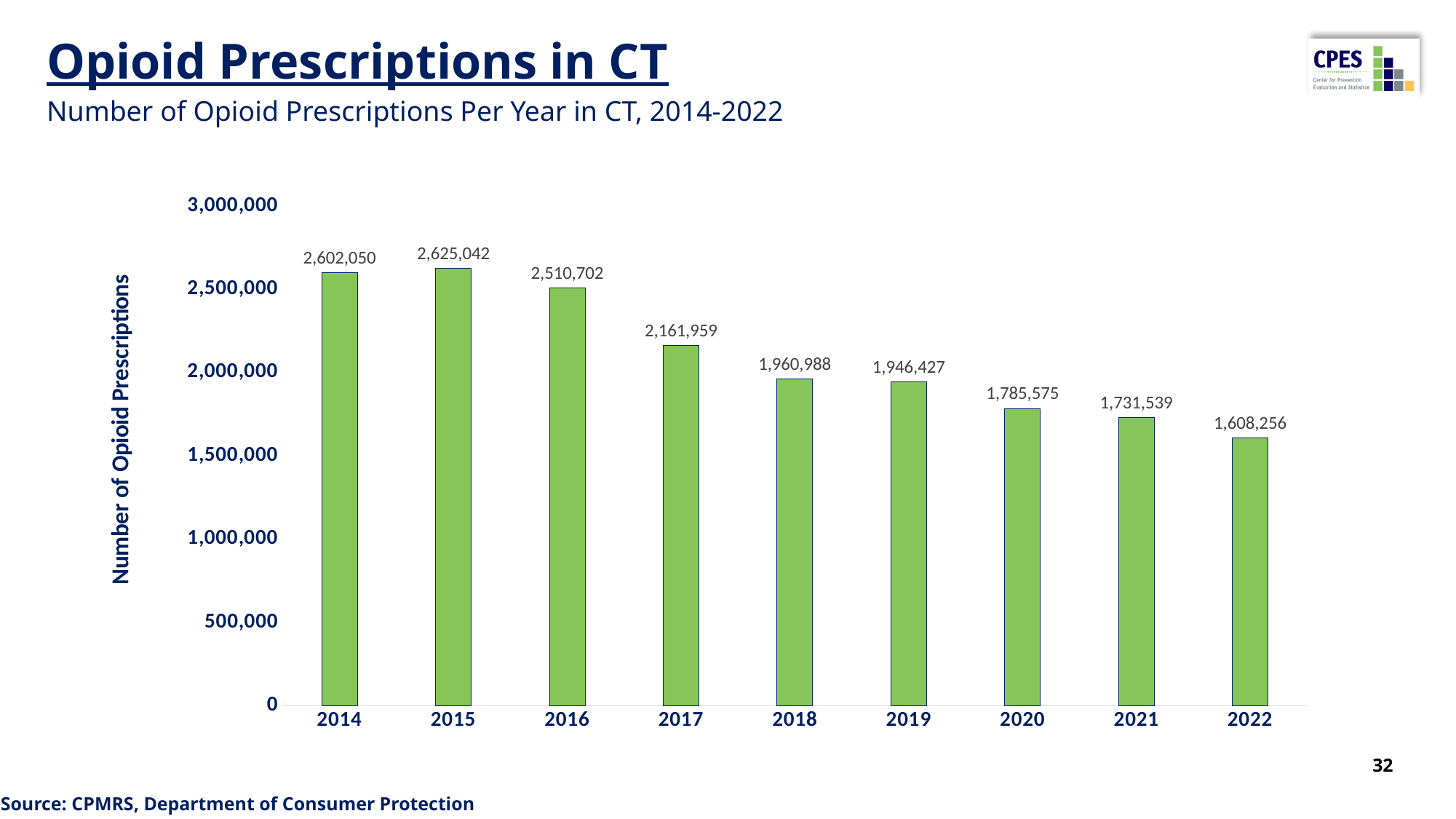
How many years are shown on the x axis? 9 Which year had the lowest number of opioid prescriptions? 2022 How many opioid prescriptions were there in CT in 2014? 2,602,050 By how much did the number of opioid prescriptions fall from 2014 to 2022? 993,794 What is the value for 2022? 1,608,256 What type of chart is shown on the slide? bar chart What is the overall trend in opioid prescriptions from 2015 to 2022? falling Which year had the highest number of opioid prescriptions? 2015 What is the number of opioid prescriptions shown for 2019? 1,946,427 Which year had more opioid prescriptions, 2018 or 2019? 2018 What is the difference between the number of prescriptions in 2015 and in 2014? 22,992 Is the value for 2017 greater or less than 2,000,000? greater